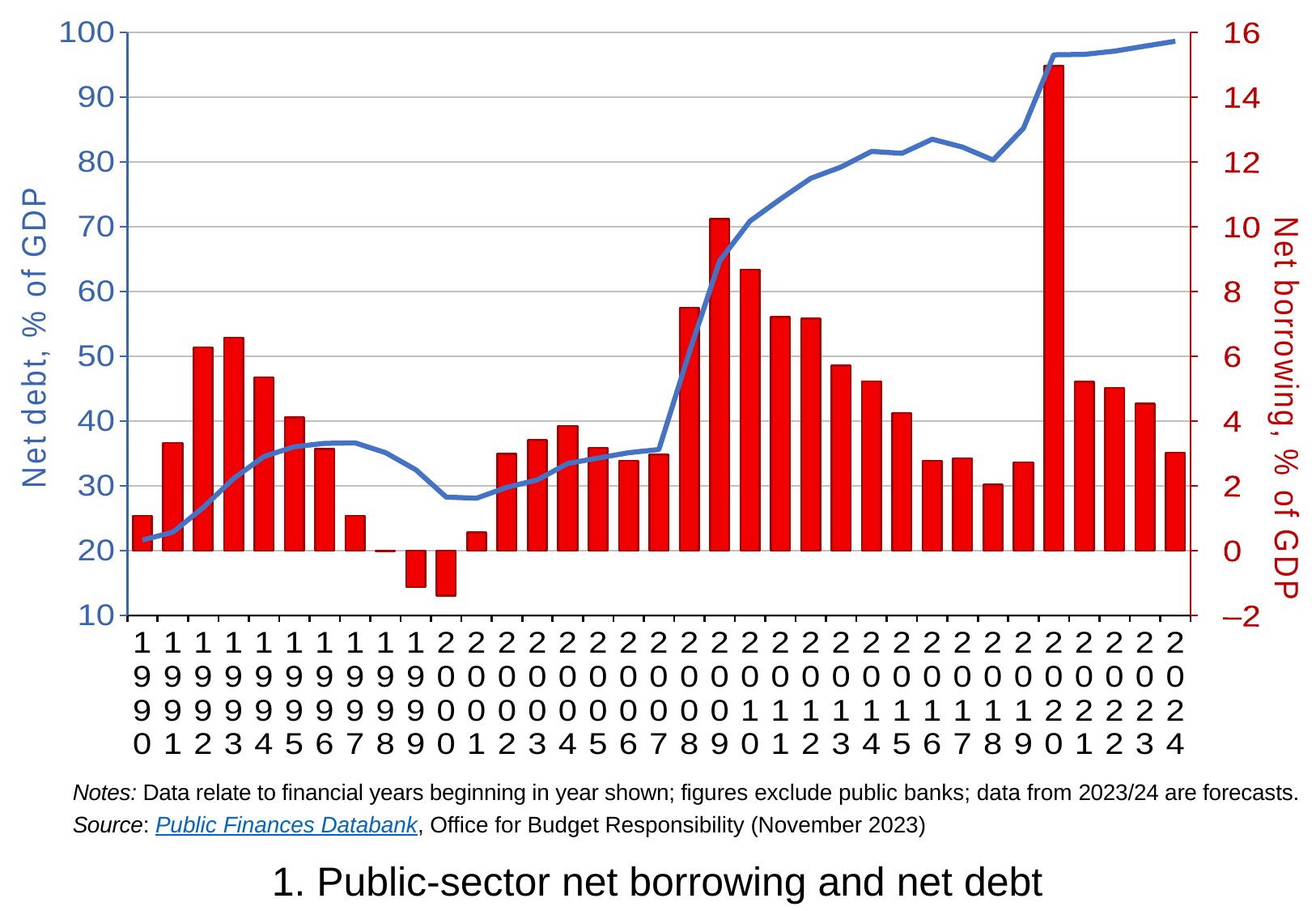
What is the label on the right-hand vertical axis? Net borrowing, % of GDP Which year has higher net borrowing, 2009 or 2010? 2009 Is net debt in 1990 greater or less than 30% of GDP? less What is the title of the chart? 1. Public-sector net borrowing and net debt In which year is net debt (the line) highest? 2024 In which year is net debt (the line) lowest? 1990 Does net debt rise or fall between 2008 and 2012? rise How many years are shown along the x axis? 35 In which year is net borrowing (the bars) highest? 2020 What kind of chart is shown on the slide? A combination bar and line chart In which year is net borrowing (the bars) lowest? 2000 Is net borrowing in 2020 greater or less than 14% of GDP? greater